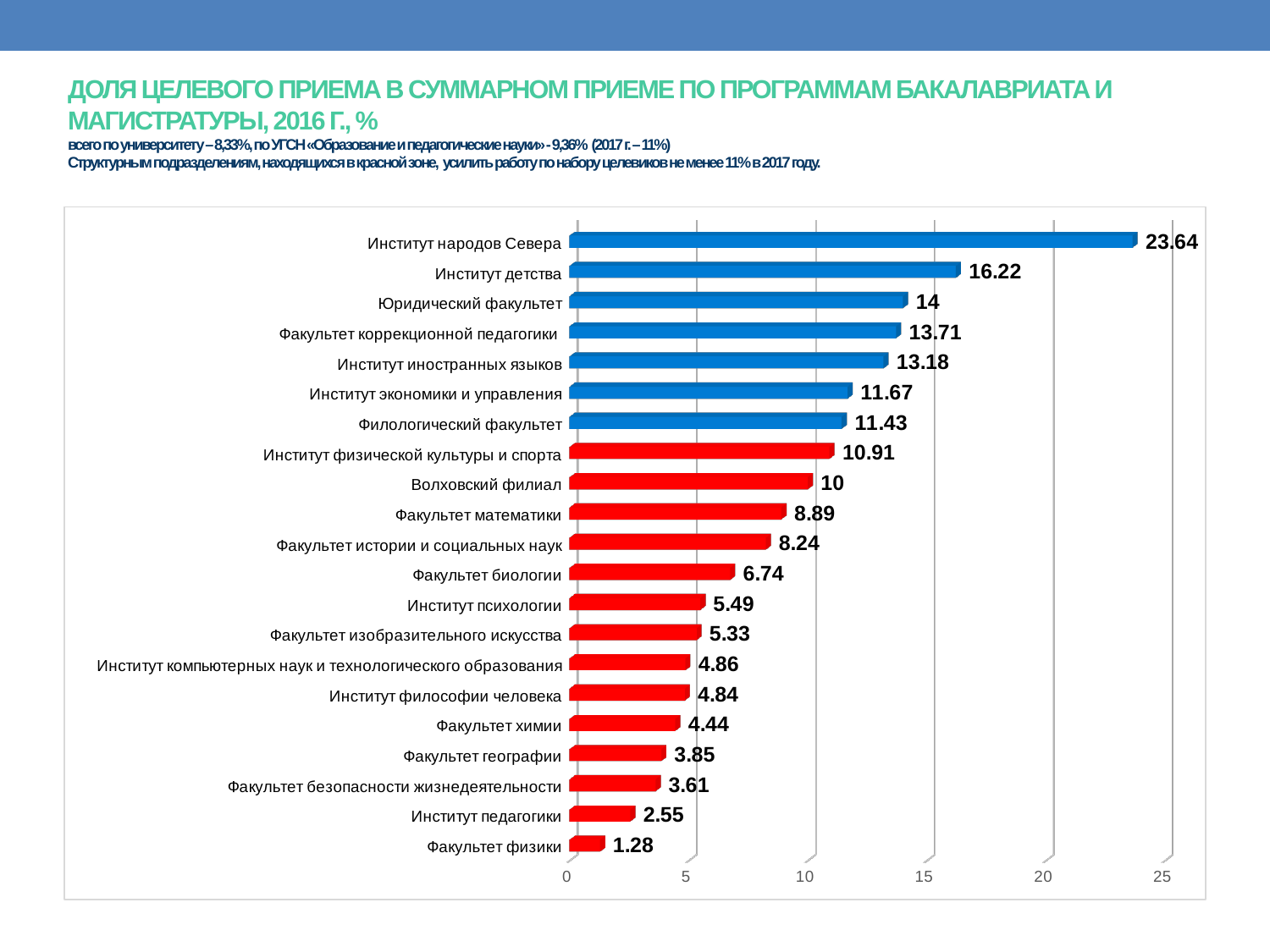
How many categories are shown in the chart? 21 What is the difference between the values for Институт детства and Юридический факультет? 2.22 Which category has the lowest value? Факультет физики What kind of chart is shown on the slide? bar chart How many bars are coloured red? 14 Which category has the highest value? Институт народов Севера What is the difference between the values for Факультет химии and Факультет физики? 3.16 Is the value for Волховский филиал greater or less than 5? greater Which is larger, the value for Факультет биологии or the value for Институт психологии? Факультет биологии What is the value for Институт народов Севера? 23.64 What is the value for Факультет математики? 8.89 What is the value for Институт философии человека? 4.84